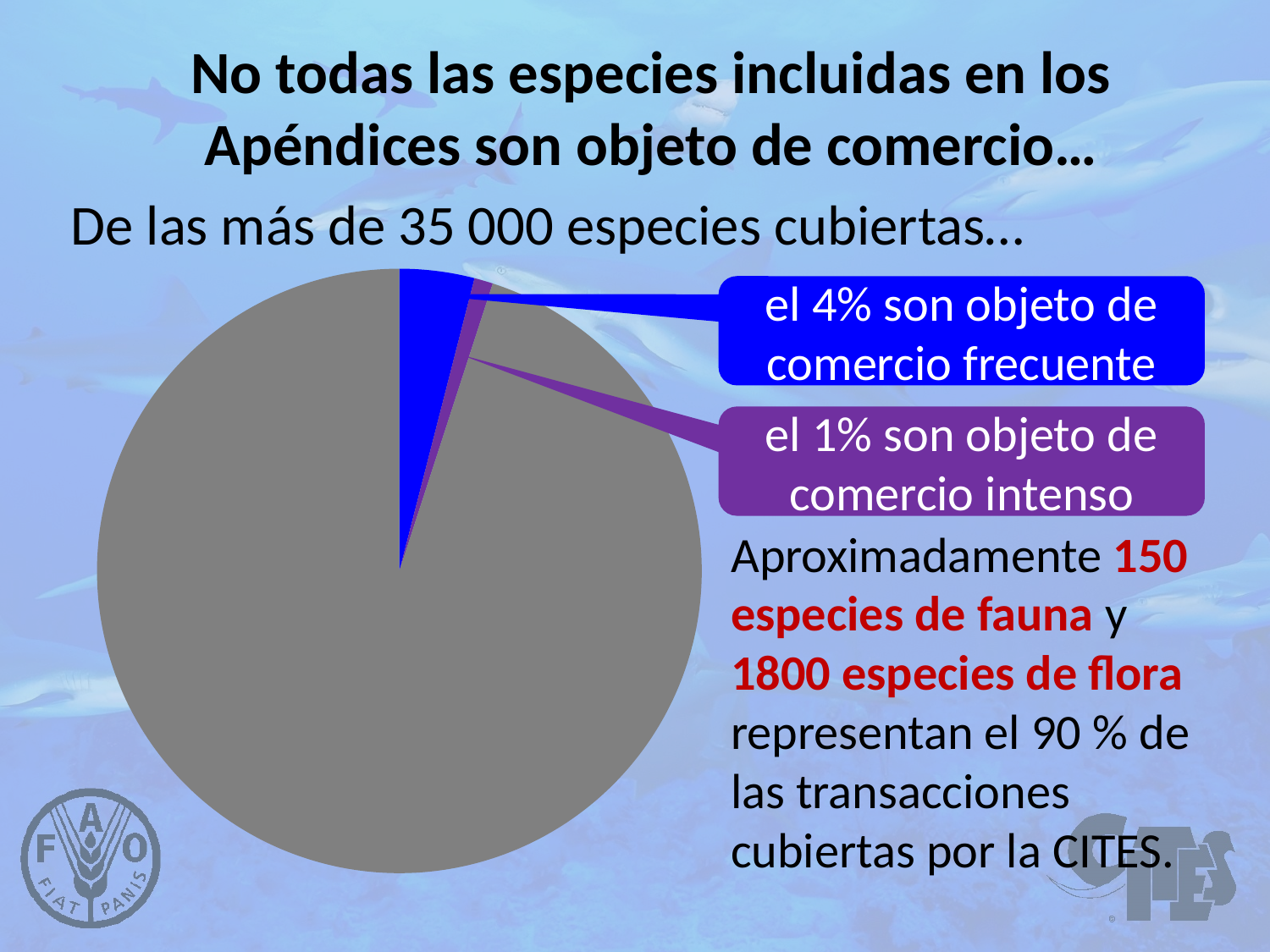
How many slices does the pie chart have? 3 Which slice of the pie chart is the largest? the grey slice What is the difference between the share for comercio frecuente and the share for comercio intenso? 3% Which labelled slice of the pie chart is the smallest? comercio intenso (1%) What share of the species are the object of intense trade (comercio intenso) according to the pie chart? 1% Which is larger in the pie chart: the slice for comercio frecuente or the slice for comercio intenso? comercio frecuente Is the share for comercio frecuente greater or less than 50%? less What share of the species are the object of frequent trade (comercio frecuente) according to the pie chart? 4% What colour is the slice representing comercio frecuente? blue What kind of chart is shown on the slide? pie chart What colour is the slice representing comercio intenso? purple